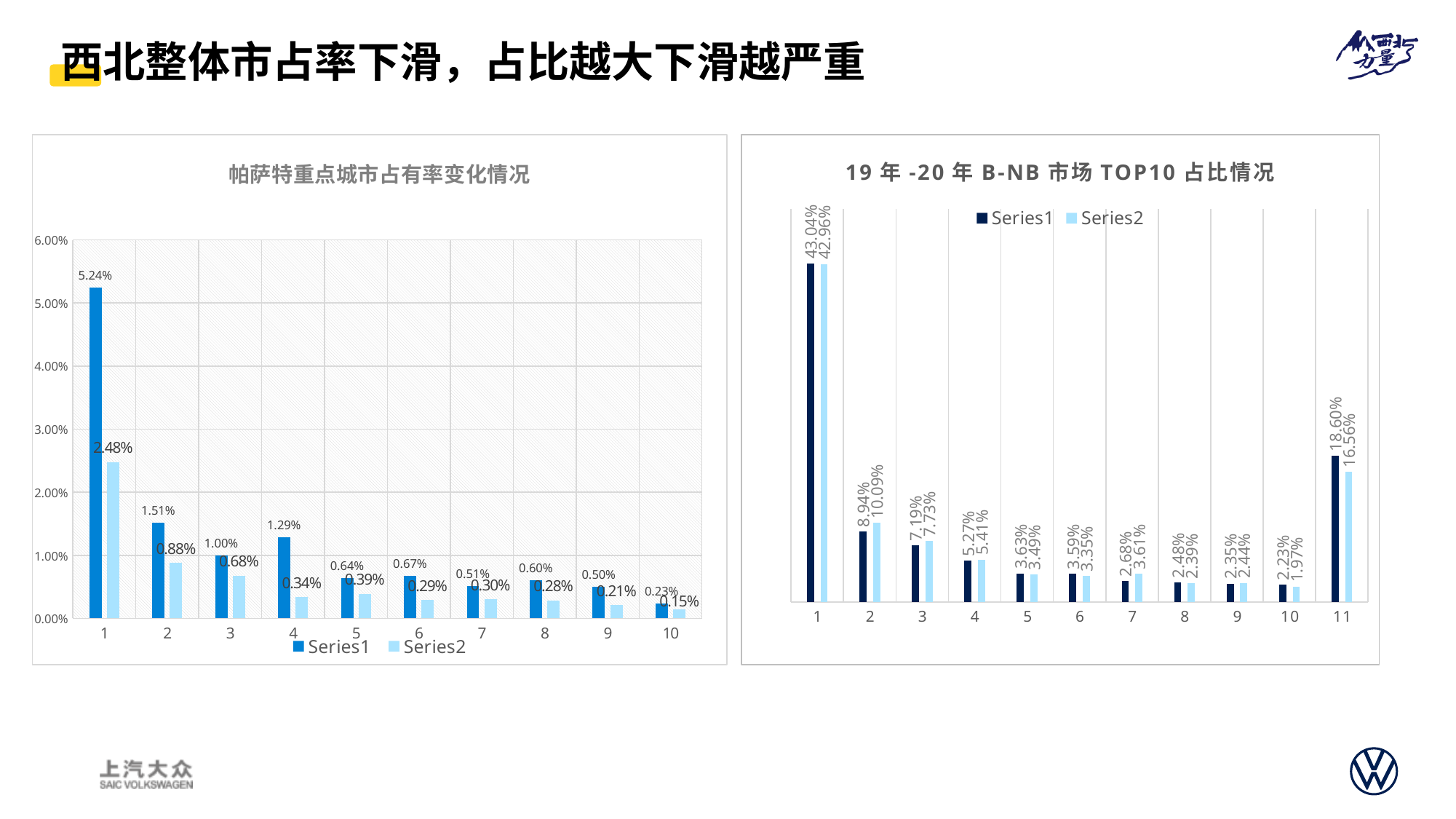
What type of chart is the right chart (19年-20年 B-NB市场TOP10占比情况)? Bar chart In the left chart (帕萨特重点城市占有率变化情况), what is the difference between the Series1 and Series2 values for category 1? 2.76% In the right chart (19年-20年 B-NB市场TOP10占比情况), what is the Series2 value for category 11? 16.56% In the left chart (帕萨特重点城市占有率变化情况), what is the Series1 value for category 1? 5.24% In the left chart (帕萨特重点城市占有率变化情况), what is the Series2 value for category 4? 0.34% In the left chart (帕萨特重点城市占有率变化情况), how many categories are shown on the x axis? 10 In the right chart (19年-20年 B-NB市场TOP10占比情况), how many series does the legend list? 2 In the right chart (19年-20年 B-NB市场TOP10占比情况), which category has the highest Series1 value? 1 In the left chart (帕萨特重点城市占有率变化情况), which category has the lowest Series1 value? 10 In the right chart (19年-20年 B-NB市场TOP10占比情况), which is larger for category 2: Series1 or Series2? Series2 In the left chart (帕萨特重点城市占有率变化情况), is the Series1 value for category 1 greater or less than 5.00%? greater In the right chart (19年-20年 B-NB市场TOP10占比情况), what is the difference between Series1 and Series2 for category 11? 2.04%